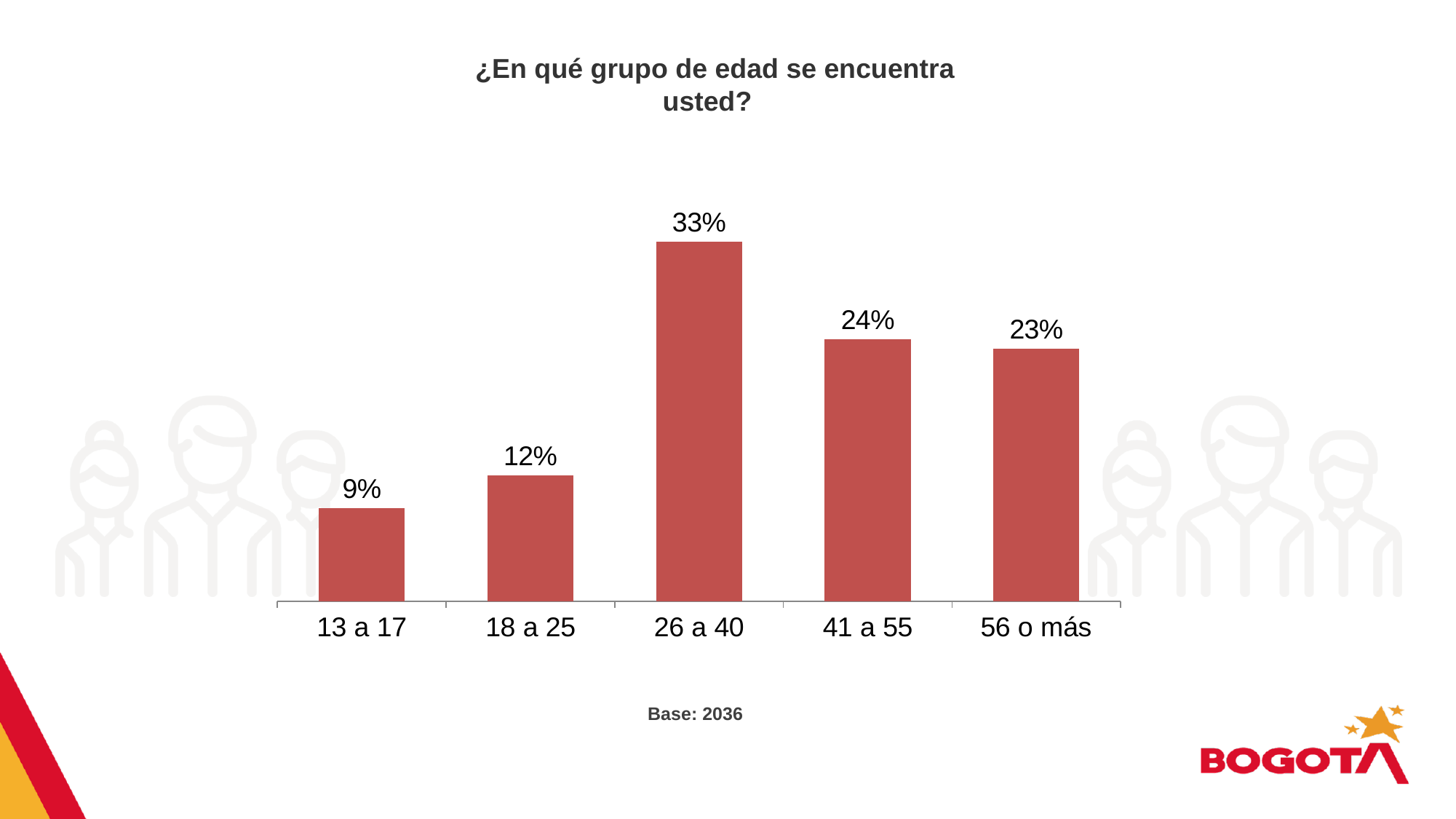
Which age group has the highest percentage? 26 a 40 How many age groups are shown on the chart? 5 What is the difference between the 18 a 25 and 13 a 17 age groups? 3% What is the value shown for the 13 a 17 age group? 9% Which is larger, the value for 18 a 25 or the value for 56 o más? 56 o más What percentage is shown for the 56 o más age group? 23% Which age group has the lowest percentage? 13 a 17 What percentage of respondents are in the 26 a 40 age group? 33% What type of chart is shown on the slide? Bar chart What is the title of the chart? ¿En qué grupo de edad se encuentra usted? What is the difference between the 26 a 40 and 41 a 55 age groups? 9% What base (number of respondents) is stated below the chart? 2036